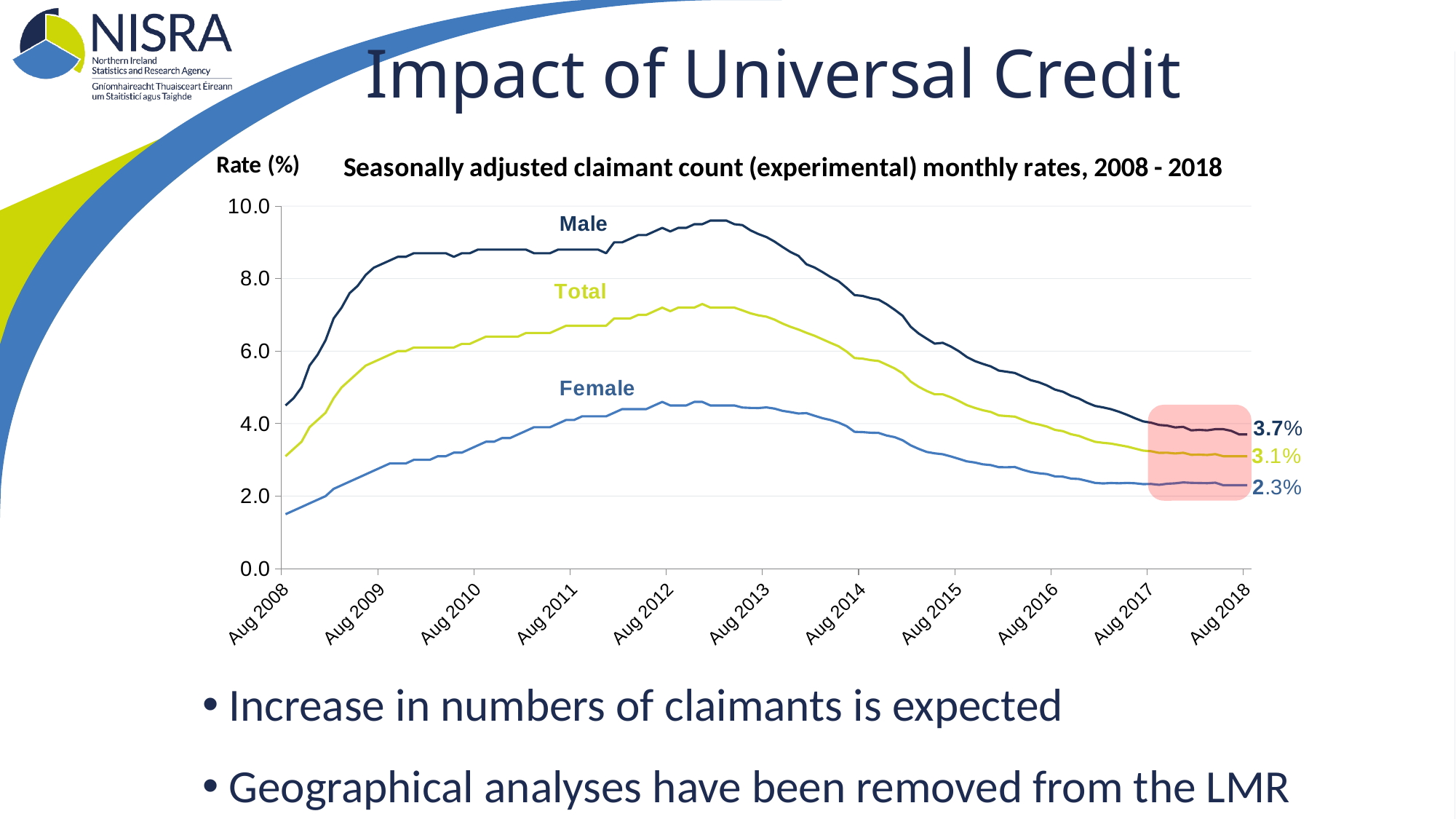
What is the Total claimant count rate shown at the end of the series (Aug 2018)? 3.1% Is the Male rate or the Total rate larger at Aug 2018? Male Which series has the highest rate at Aug 2018? Male Which series has the lowest rate at Aug 2018? Female Does the Male rate rise or fall between Aug 2013 and Aug 2018? Fall What is the difference between the Male and Female rates at Aug 2018? 1.4 percentage points Is the Female rate at Aug 2008 greater or less than 2.0? less What is the Female claimant count rate shown at the end of the series (Aug 2018)? 2.3% How many series are plotted on the chart? 3 Is the Male rate at its peak around 2013 greater or less than 8.0? greater What kind of chart is shown on the slide? Line chart What is the Male claimant count rate shown at the end of the series (Aug 2018)? 3.7%